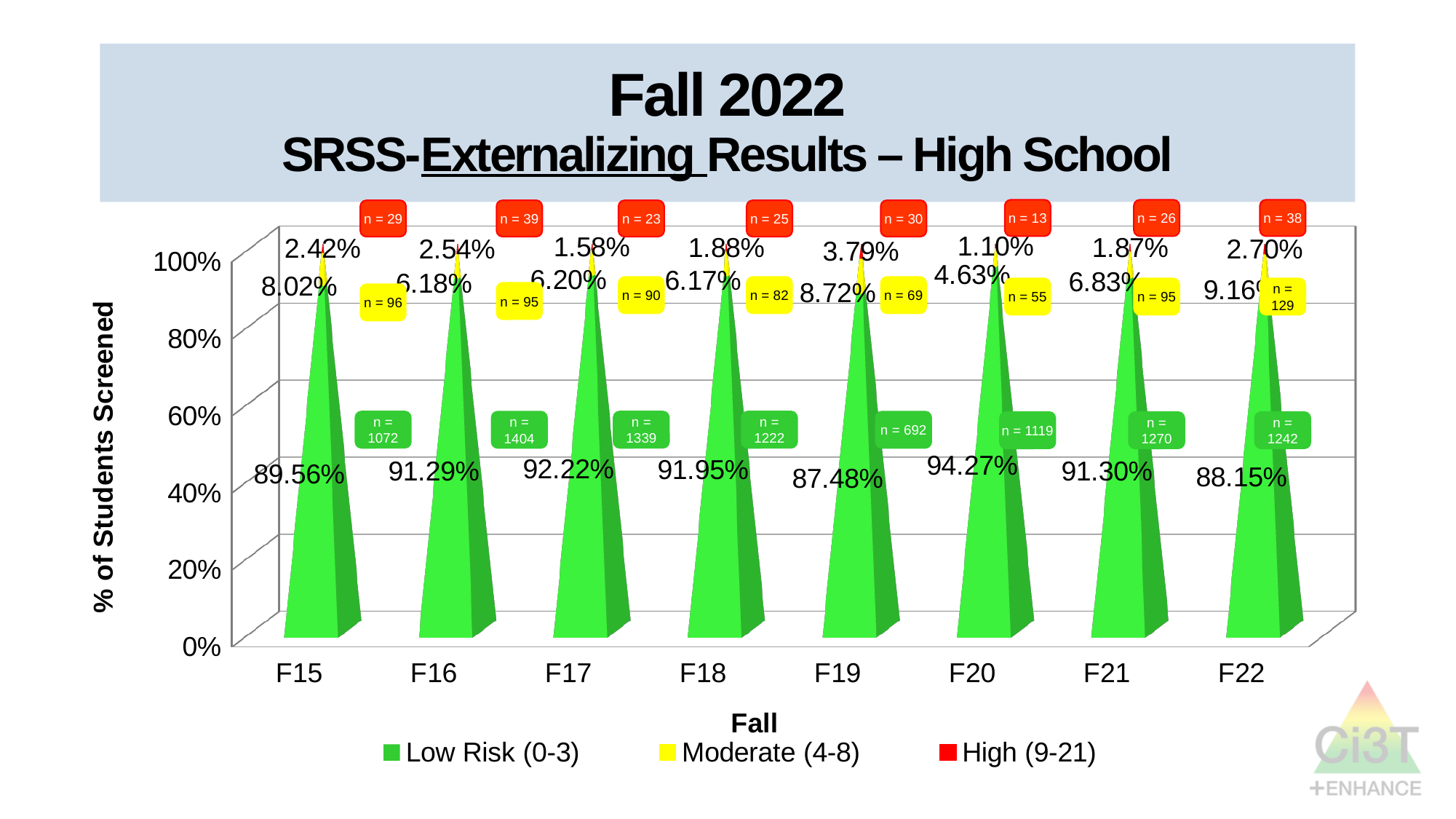
What is the Moderate (4-8) percentage for F19? 8.72% Which fall has the lowest Low Risk (0-3) percentage? F19 How many series does the legend list? 3 Is the Low Risk (0-3) percentage higher for F17 or F22? F17 Which fall has the highest High (9-21) percentage? F19 What is the label of the y axis? % of Students Screened What is the High (9-21) percentage for F16? 2.54% Which fall has the lowest High (9-21) percentage? F20 How many fall categories are shown on the x axis? 8 Which fall has the highest Low Risk (0-3) percentage? F20 What is the difference between the Low Risk (0-3) percentages for F20 and F19? 6.79% What is the Low Risk (0-3) percentage for F20? 94.27%